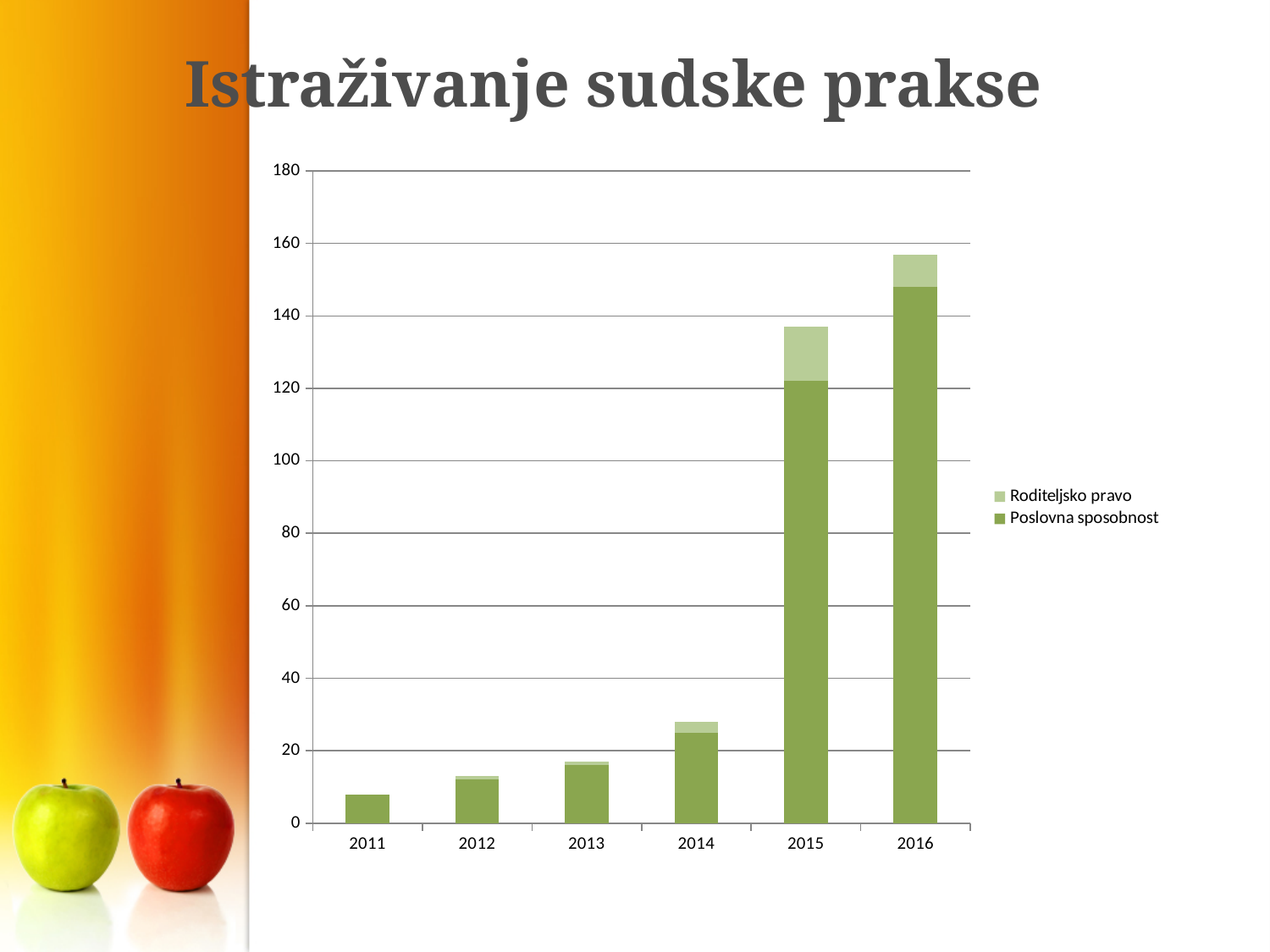
Is the total value for 2014 greater or less than 20? greater Is the total value for 2015 greater or less than 120? greater What kind of chart is shown on the slide? Stacked bar chart How many years are shown on the x axis? 6 Is the Poslovna sposobnost value for 2016 greater or less than 120? greater How many series does the legend list? 2 Which year has the highest total bar? 2016 Do the total bar values rise or fall from 2011 to 2016? rise Which year has the lowest total bar? 2011 Which series is shown in the lighter green colour? Roditeljsko pravo